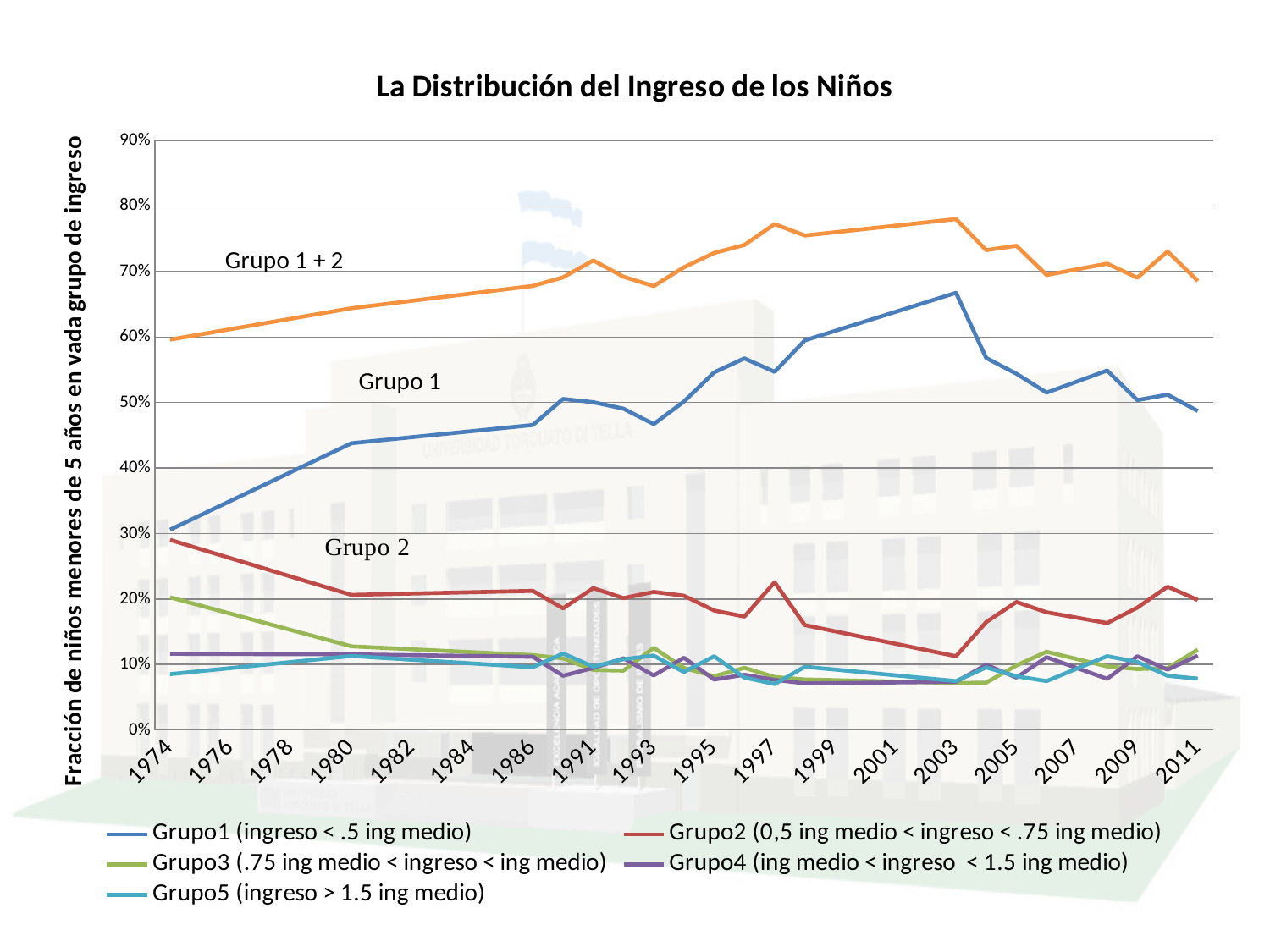
In which year does the Grupo 1 line reach its highest value? 2003 Is the value for Grupo 2 in 2003 greater or less than 20%? less What kind of chart is shown on the slide? line chart According to the legend, which income range defines Grupo5? ingreso > 1.5 ing medio What is the title of the chart? La Distribución del Ingreso de los Niños In 2011, which is larger: the value for Grupo 1 or the value for Grupo 2? Grupo 1 Is the value for Grupo 3 in 1974 greater or less than 10%? greater Is the value for Grupo 1 in 1974 greater or less than 40%? less How many series does the legend list? 5 Does the Grupo 1 line rise or fall between 1974 and 2003? rise